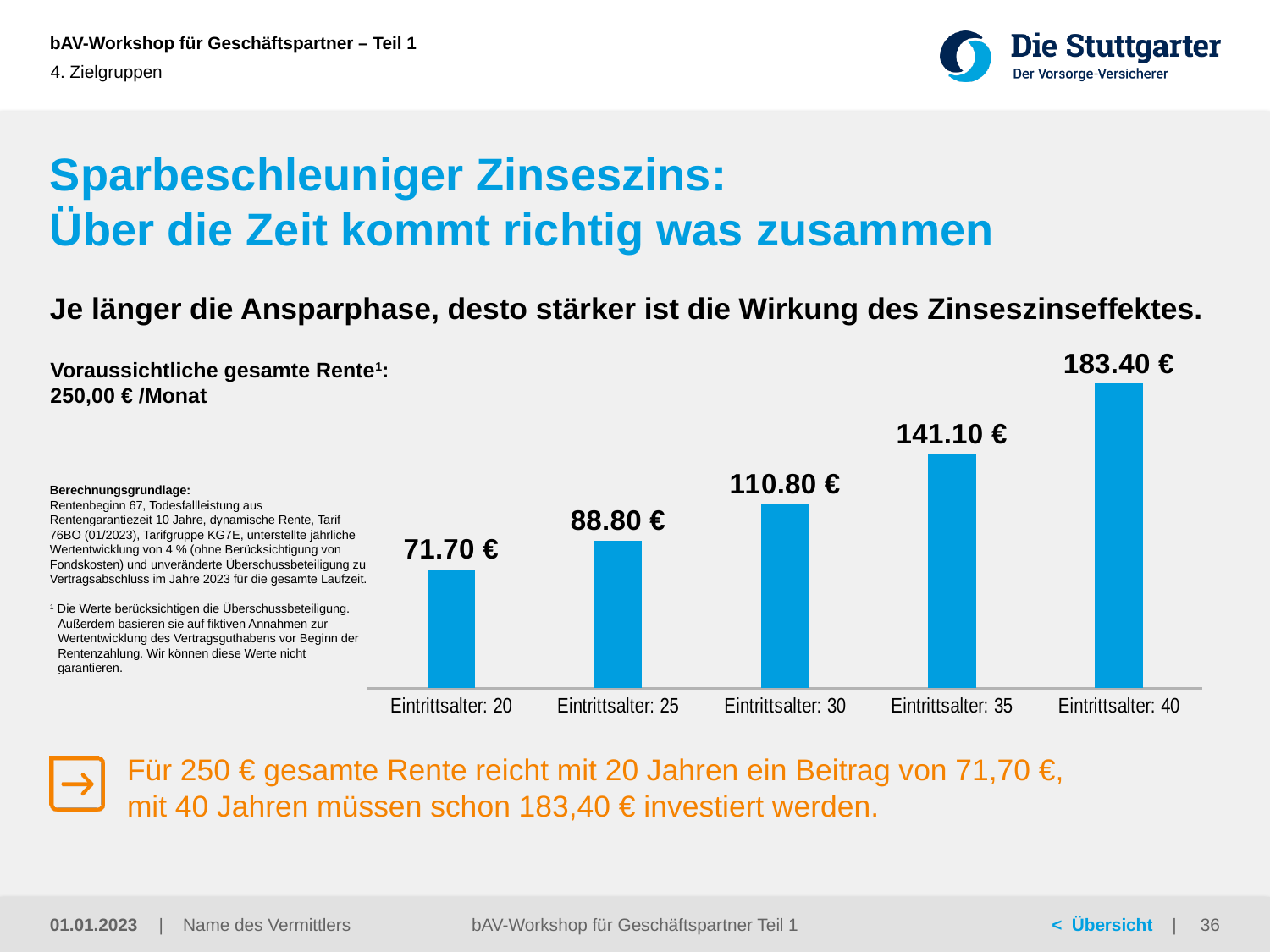
Do the values rise or fall as the Eintrittsalter increases from 20 to 40? Rise What is the value shown for Eintrittsalter: 30? 110.80 € Which category has the lowest value? Eintrittsalter: 20 Which category has the highest value? Eintrittsalter: 40 How many categories are shown in the chart? 5 What is the value shown for Eintrittsalter: 40? 183.40 € Which is larger, the value for Eintrittsalter: 25 or for Eintrittsalter: 30? Eintrittsalter: 30 What is the value shown for Eintrittsalter: 35? 141.10 € What is the difference between the values for Eintrittsalter: 35 and Eintrittsalter: 30? 30.30 € What is the difference between the values for Eintrittsalter: 40 and Eintrittsalter: 20? 111.70 € What is the value shown for Eintrittsalter: 20? 71.70 € What kind of chart is shown on the slide? Bar chart